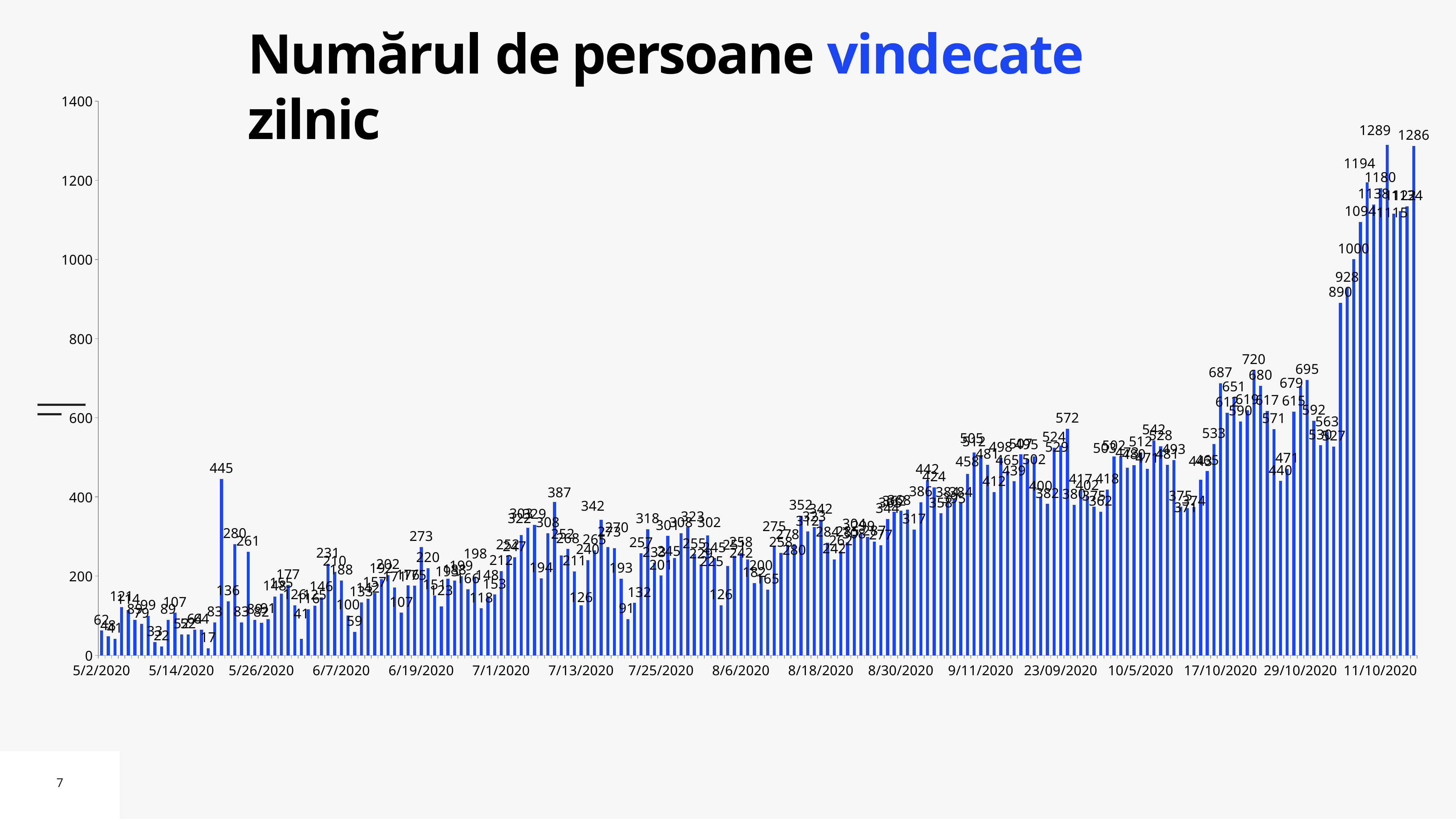
Which is larger, the value of the first bar (5/2/2020) or the value of the last bar? the last bar What is the highest value labeled on the chart? 1289 What is the lowest value labeled on the chart? 17 What is the difference between the highest value (1289) and the lowest value (17) on the chart? 1272 What is the difference between the highest value (1289) and the last bar's value (1286)? 3 What kind of chart is shown on the slide? bar chart What is the title of the chart? Numărul de persoane vindecate zilnic What is the value of the last bar on the right of the chart? 1286 Is the value of the last bar on the chart greater or less than 1200? greater Overall, do the values rise or fall from left to right along the x axis? rise What is the value of the tallest bar between the 5/14/2020 and 5/26/2020 ticks? 445 What is the value for 5/2/2020, the first bar of the chart? 62